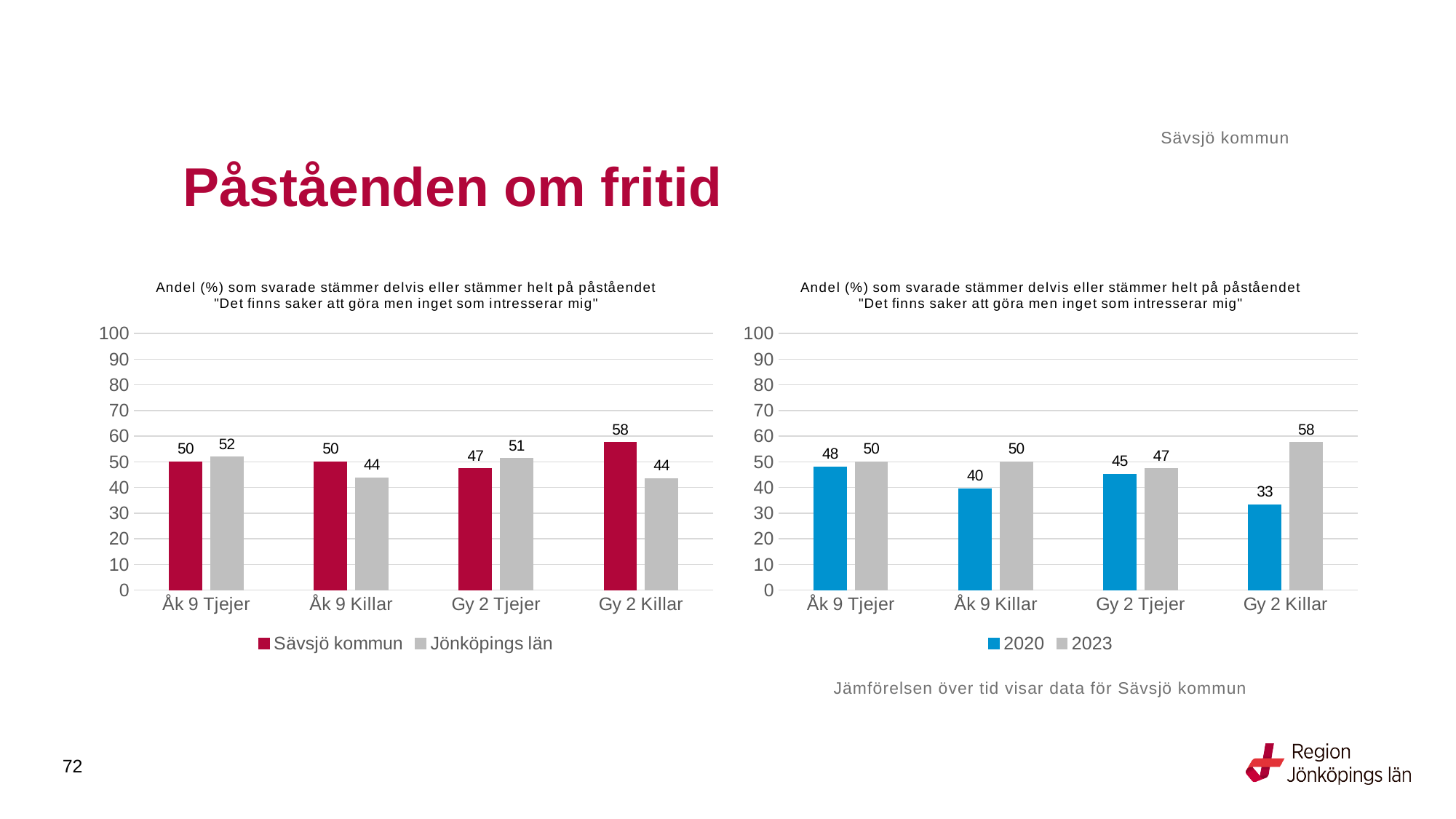
In the left chart, what is the value for Sävsjö kommun for Gy 2 Killar? 58 In the left chart, which is larger for Gy 2 Tjejer: Sävsjö kommun or Jönköpings län? Jönköpings län In the left chart, what is the difference between the Sävsjö kommun and Jönköpings län values for Gy 2 Killar? 14 In the right chart, which category has the lowest value for 2020? Gy 2 Killar What kind of chart is the right chart? Bar chart How many categories are shown on the x axis of the right chart? 4 How many series does the legend of the left chart list? 2 In the left chart, what is the value for Jönköpings län for Åk 9 Killar? 44 In the left chart, which category has the highest value for Sävsjö kommun? Gy 2 Killar In the right chart, what is the value for 2023 for Åk 9 Killar? 50 In the right chart, what is the difference between the 2023 and 2020 values for Gy 2 Killar? 25 In the right chart, what is the value for 2020 for Gy 2 Killar? 33